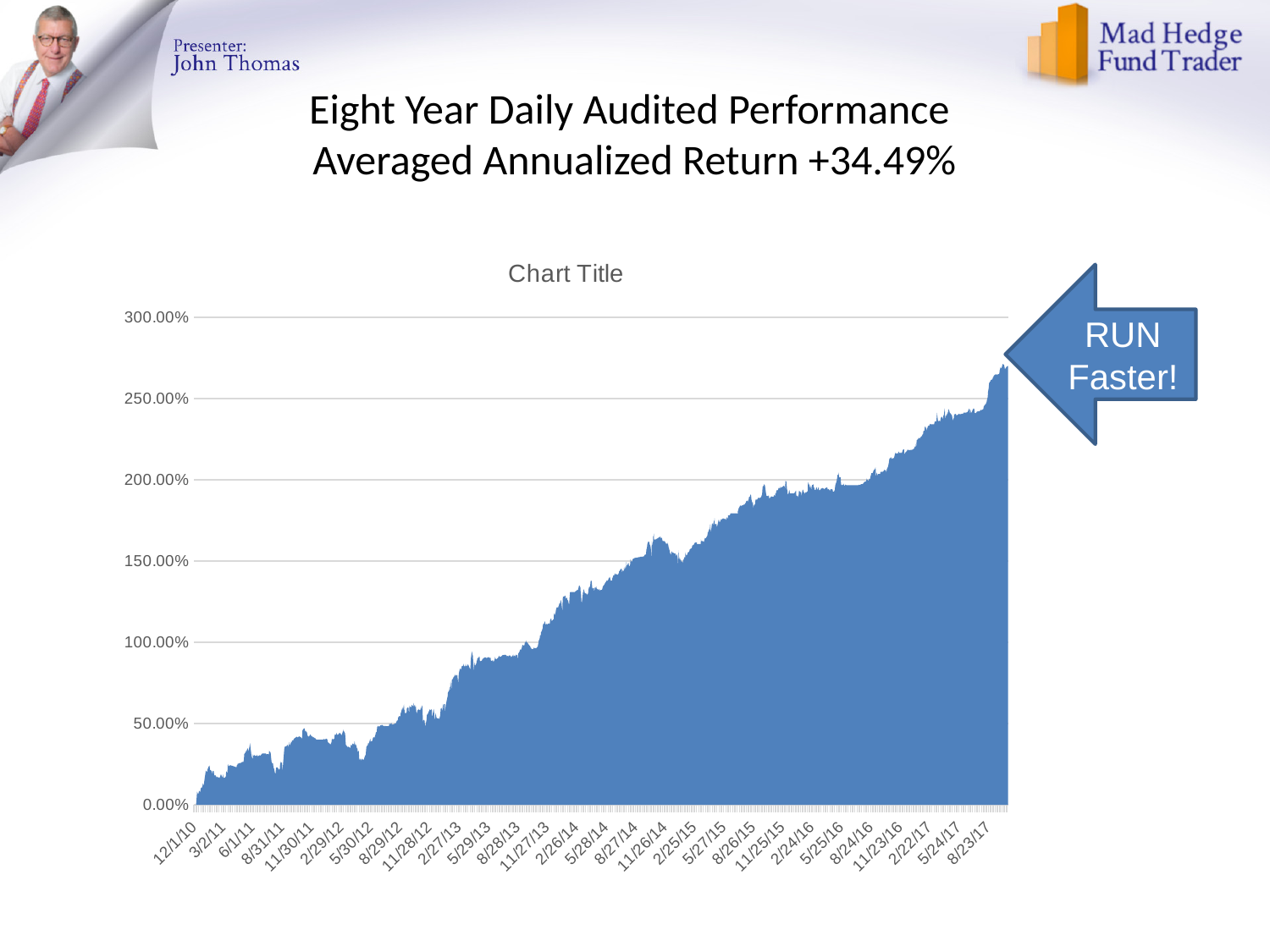
Is the value around 8/27/14 greater or less than 200.00%? less Is the value around 5/30/12 greater or less than 50.00%? less Is the value at the end of the chart (8/23/17) greater or less than 250.00%? greater What is the first date label on the x axis of the chart? 12/1/10 What is the highest tick label shown on the y axis of the chart? 300.00% Do the values in the chart generally rise or fall from left to right along the x axis? Rise What kind of chart is shown on the slide? Area chart What title is displayed above the chart? Chart Title